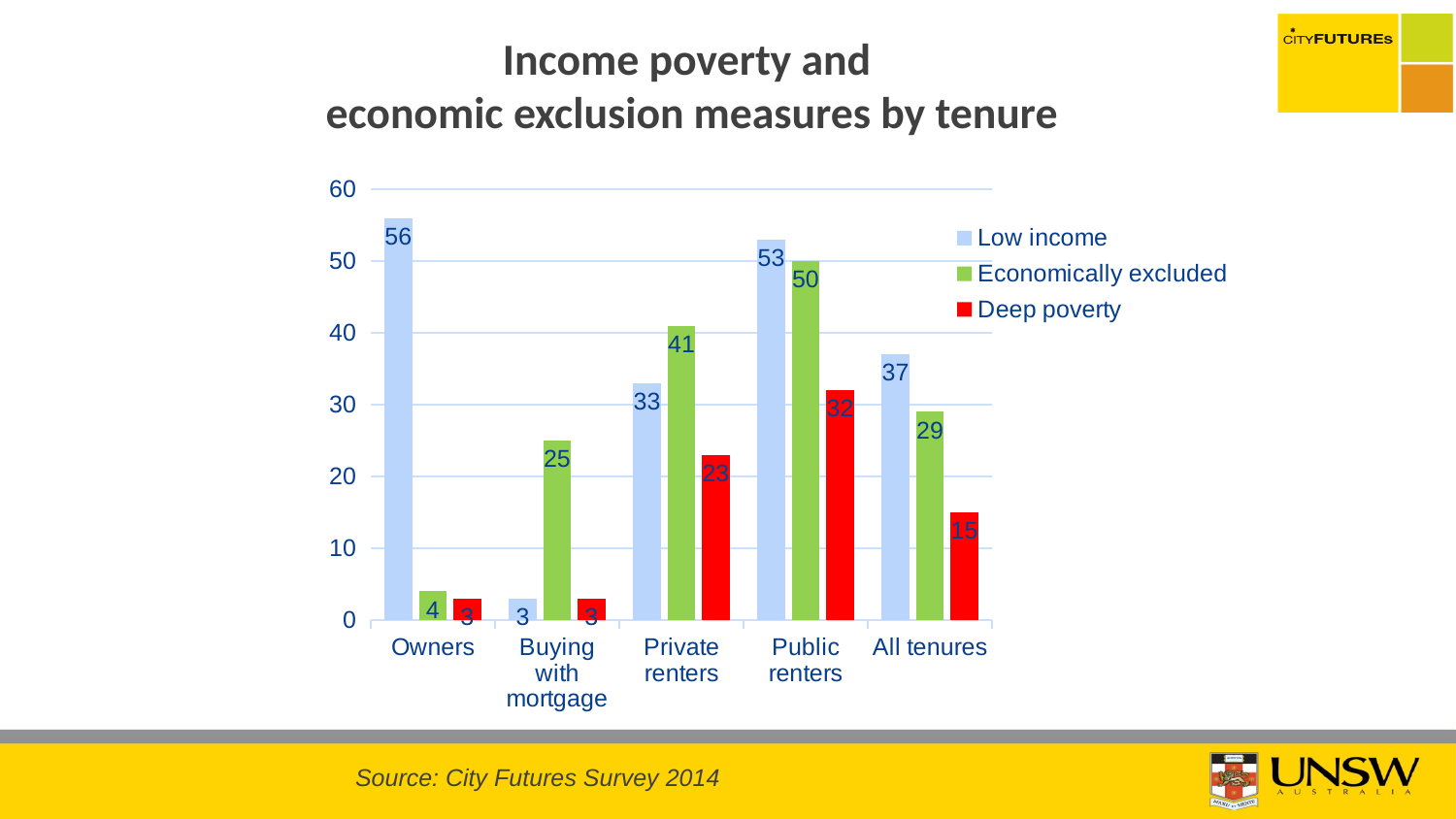
Which colour represents the Deep poverty series? Red How many tenure categories are shown on the x axis? 5 Which tenure has the highest Deep poverty value? Public renters What is the Economically excluded value for Buying with mortgage? 25 For Private renters, which is larger: the Low income value or the Economically excluded value? Economically excluded What is the Deep poverty value for Public renters? 32 What is the difference between the Low income value for Public renters and the Low income value for All tenures? 16 Which tenure has the lowest Low income value? Buying with mortgage What kind of chart is shown on the slide? Bar chart What is the Low income value for Owners? 56 What is the Economically excluded value for Private renters? 41 How many series does the legend list? 3